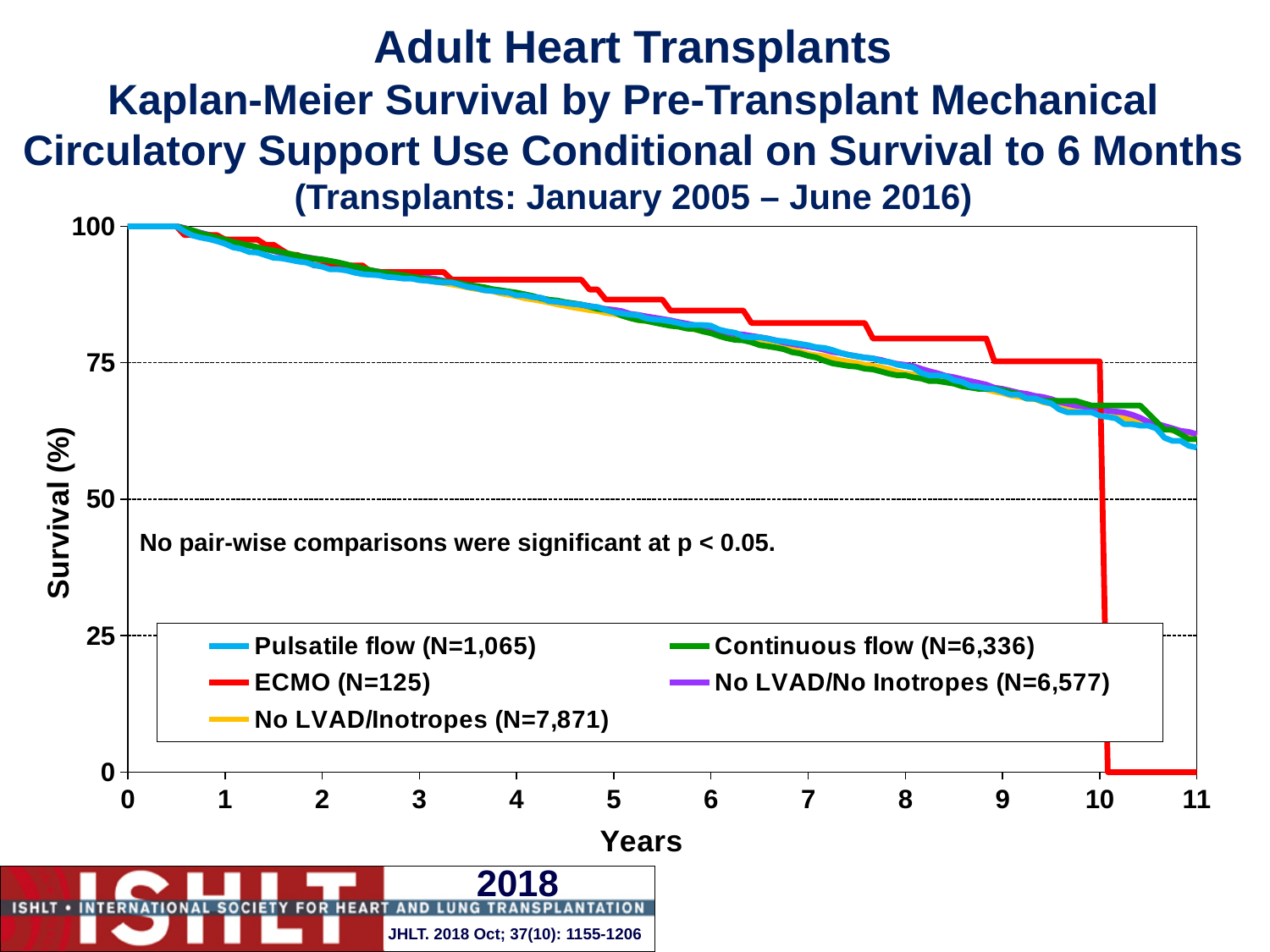
Which series is drawn in red? ECMO (N=125) At 8 years, which has higher survival: ECMO or Continuous flow? ECMO Is the survival for Pulsatile flow at 5 years greater or less than 75? greater Which series drops to 0% survival at about 10 years? ECMO What kind of chart is shown on the slide? Line chart What is the survival value for ECMO at 11 years? 0 How many series does the legend list? 5 Do the survival curves rise or fall as years increase? Fall What is the label on the y axis? Survival (%) At 11 years, which has higher survival: Pulsatile flow or ECMO? Pulsatile flow Is the survival for ECMO at 8 years greater or less than 75? greater Is the survival for Continuous flow at 11 years greater or less than 75? less